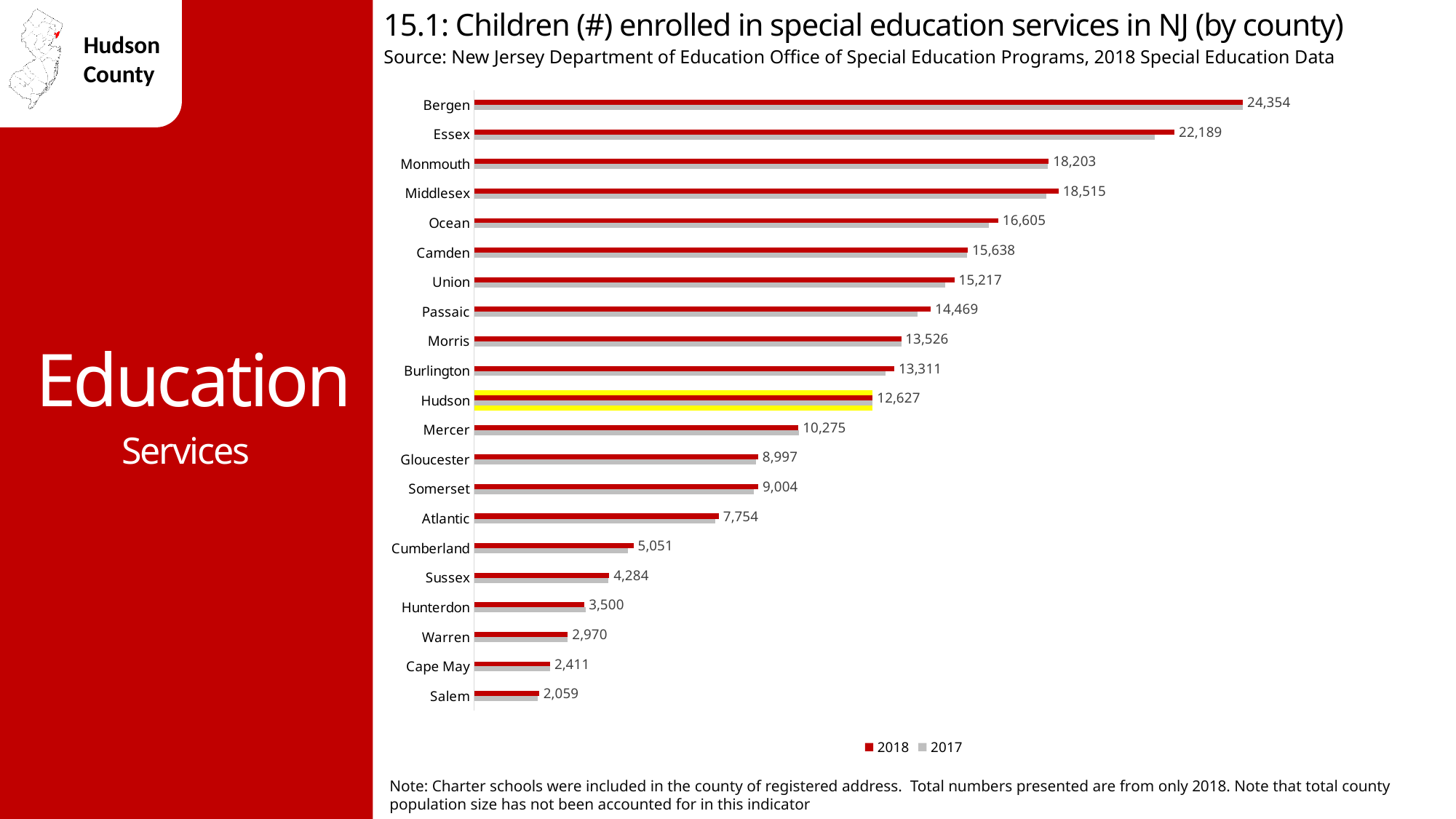
Which county has the larger 2018 value, Middlesex or Monmouth? Middlesex Which county has the highest number of children enrolled in special education services in 2018? Bergen How many counties are shown on the chart? 21 Which county has the lowest number of children enrolled in special education services in 2018? Salem What kind of chart is shown on the slide? Bar chart What is the difference between the 2018 values for Bergen and Essex? 2,165 What is the 2018 value for Hudson County? 12,627 What is the 2018 value for Cumberland County? 5,051 What is the difference between the 2018 values for Hudson and Mercer? 2,352 What is the 2018 value for Bergen County? 24,354 How many series does the legend list? 2 Which county's bars are highlighted in yellow on the chart? Hudson